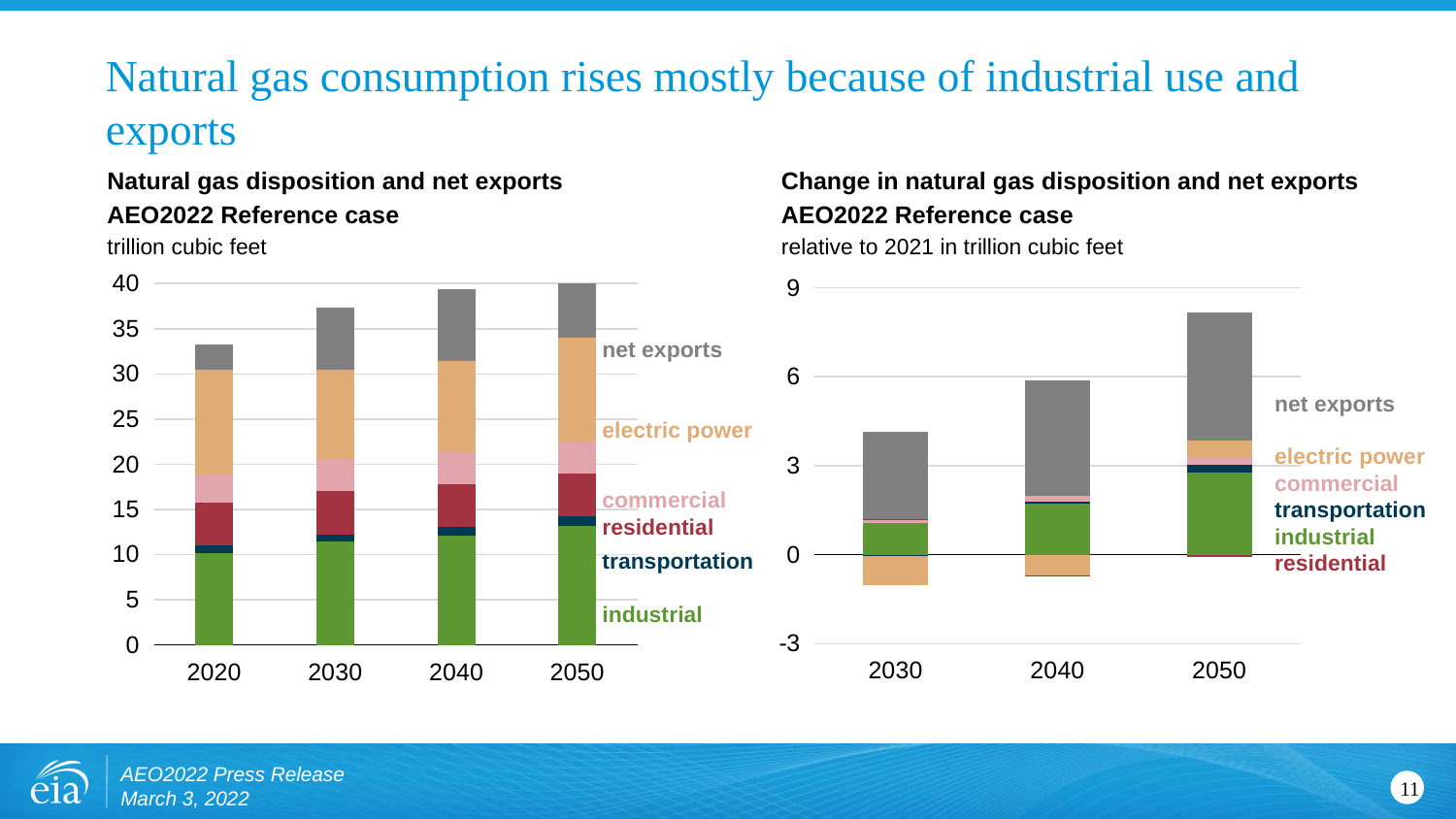
In the right chart, 'Change in natural gas disposition and net exports', is the top of the 2050 stacked bar greater or less than 6? greater In the left chart, 'Natural gas disposition and net exports', which year has the shortest stacked bar? 2020 What unit is given for the left chart, 'Natural gas disposition and net exports'? trillion cubic feet How many series are labelled on the left chart, 'Natural gas disposition and net exports'? 6 In the left chart, 'Natural gas disposition and net exports', is the total for 2030 greater or less than 35? greater In the left chart, 'Natural gas disposition and net exports', do the stacked bar totals rise or fall from 2020 to 2050? rise What kind of chart is the left chart titled 'Natural gas disposition and net exports'? stacked bar chart In the left chart, 'Natural gas disposition and net exports', which year has the tallest stacked bar? 2050 In the left chart, 'Natural gas disposition and net exports', is the total for 2020 greater or less than 30? greater In the right chart, 'Change in natural gas disposition and net exports', which series is shown below zero in 2030 and 2040? electric power How many years are shown on the x axis of the right chart, 'Change in natural gas disposition and net exports'? 3 How many years are shown on the x axis of the left chart, 'Natural gas disposition and net exports'? 4